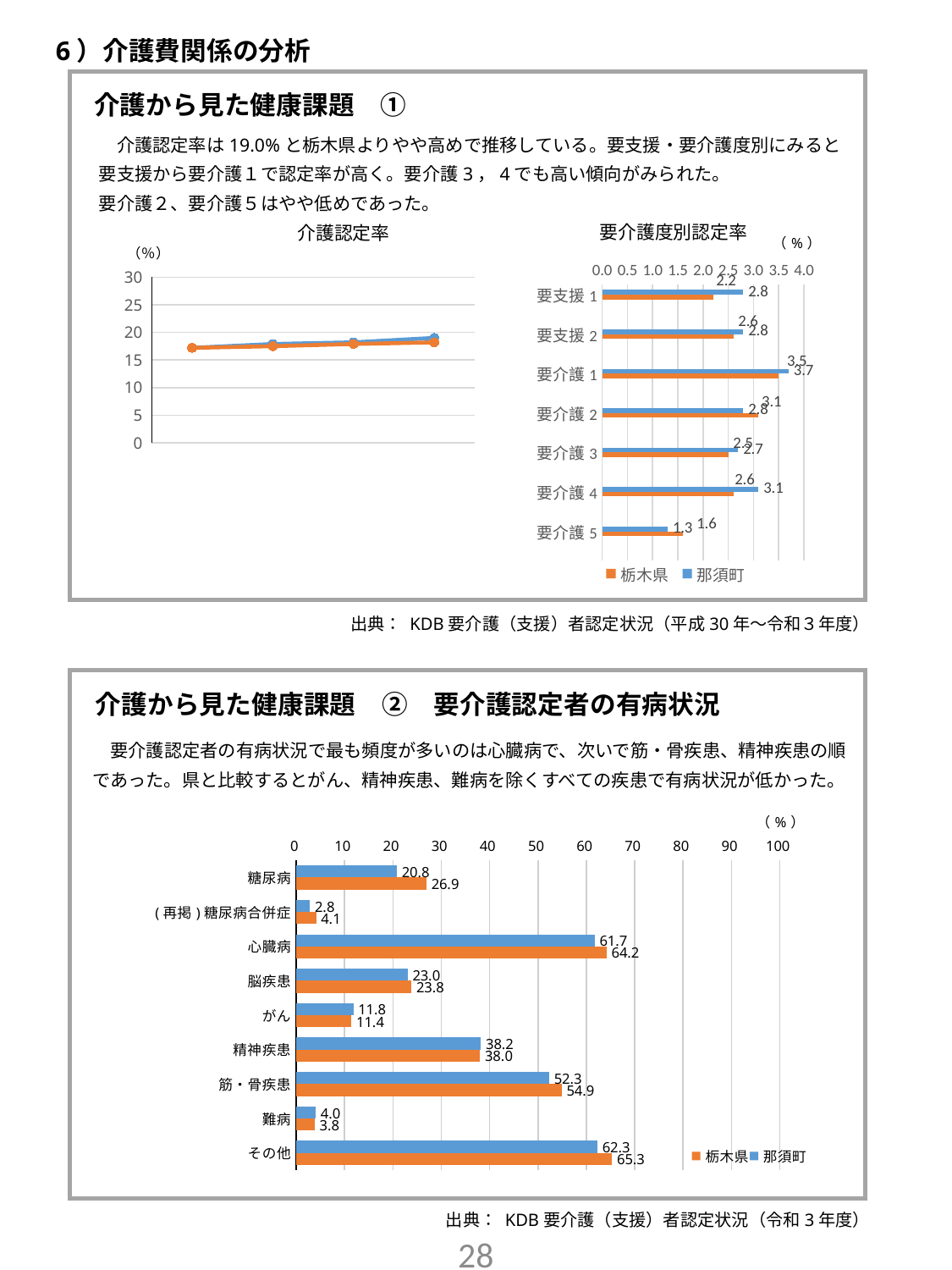
In the 要介護度別認定率 chart, how many series does the legend list? 2 In the 要介護認定者の有病状況 chart, what is the value for 那須町 for 心臓病? 61.7 In the 要介護度別認定率 chart, what is the value for 那須町 in 要介護1? 3.7 In the 要介護認定者の有病状況 chart, which colour represents 那須町? blue In the 要介護度別認定率 chart, which category has the lowest value for 那須町? 要介護5 What kind of chart is the 介護認定率 chart? line chart In the 介護認定率 chart, how many data points does each line have? 4 In the 要介護認定者の有病状況 chart, which is larger for 筋・骨疾患, 栃木県 or 那須町? 栃木県 In the 要介護度別認定率 chart, what is the value for 栃木県 in 要介護5? 1.6 In the 要介護認定者の有病状況 chart, how many disease categories are shown? 9 In the 介護認定率 chart, are the plotted values greater or less than 10? greater In the 要介護認定者の有病状況 chart, what is the difference between 栃木県 and 那須町 for 糖尿病? 6.1